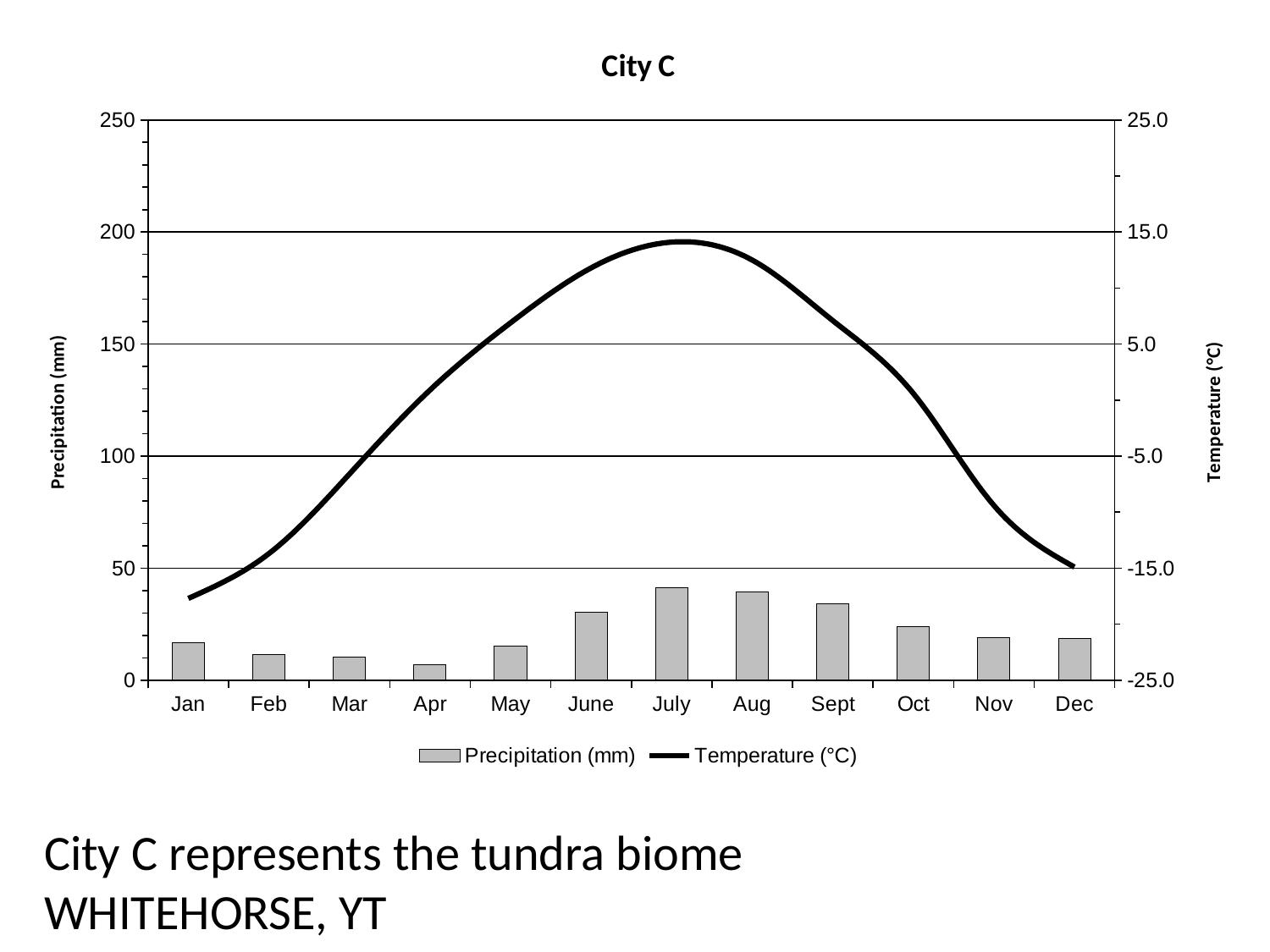
Which month has the highest temperature in the City C chart? July Is the temperature for Jan greater or less than -5.0 °C? less Is the temperature for Oct greater or less than -5.0 °C? greater Does the temperature rise or fall from Jan to July? rise Which month has the lowest precipitation in the City C chart? Apr Is the temperature for July greater or less than 5.0 °C? greater How many series does the legend of the City C chart list? 2 Which month has higher precipitation, June or Apr? June How many months are shown on the x axis of the City C chart? 12 What kind of chart is shown on the slide? A combined bar and line chart What is the title of the chart? City C